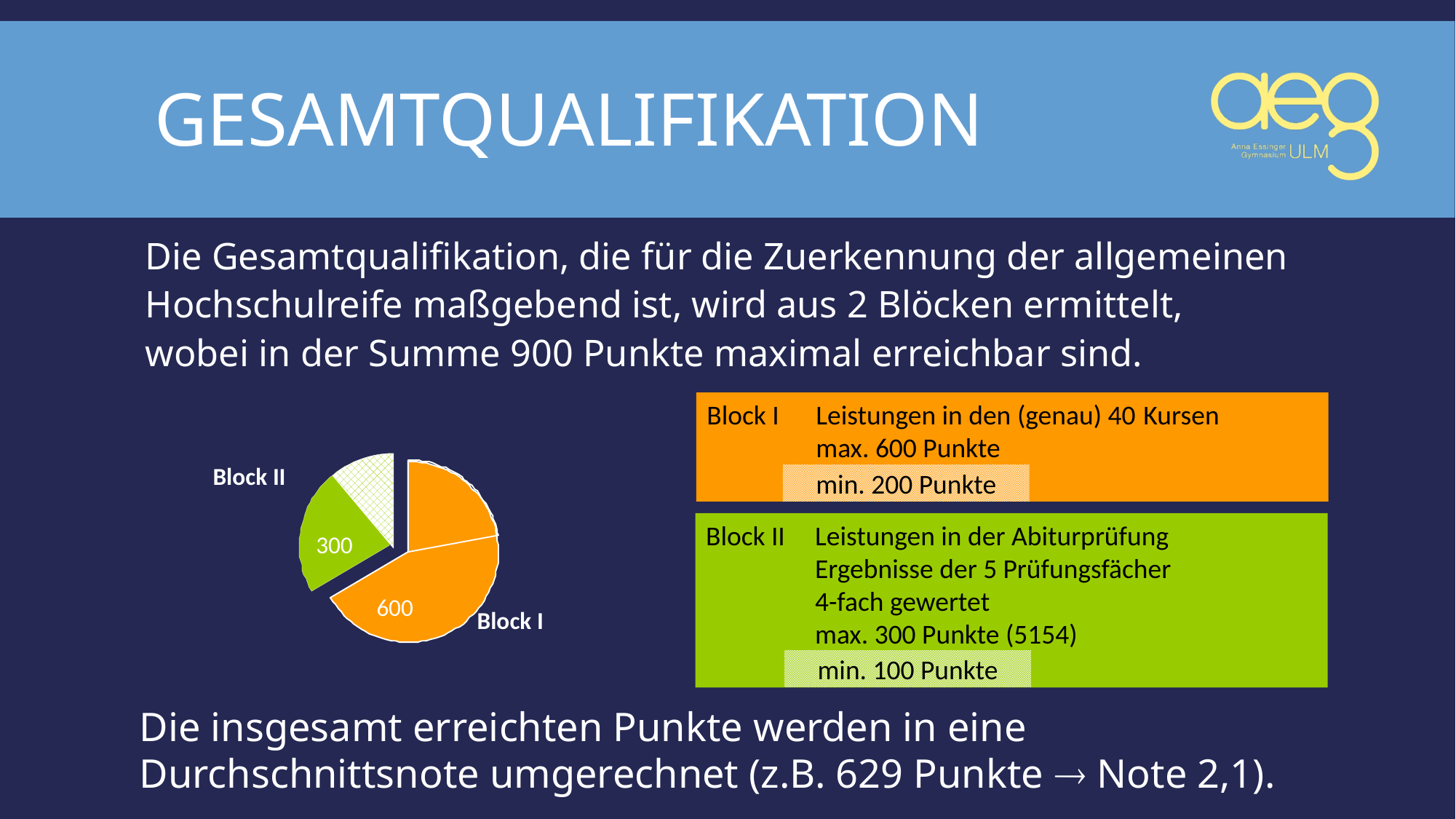
Which is larger in the pie chart, Block I or Block II? Block I What value is shown for Block I in the pie chart? 600 What value is shown for Block II in the pie chart? 300 What is the difference between the values for Block I and Block II in the pie chart? 300 What kind of chart is shown on the slide? pie chart What colour is the Block I slice in the pie chart? orange Which block has the largest slice in the pie chart? Block I What colour is the Block II slice in the pie chart? green